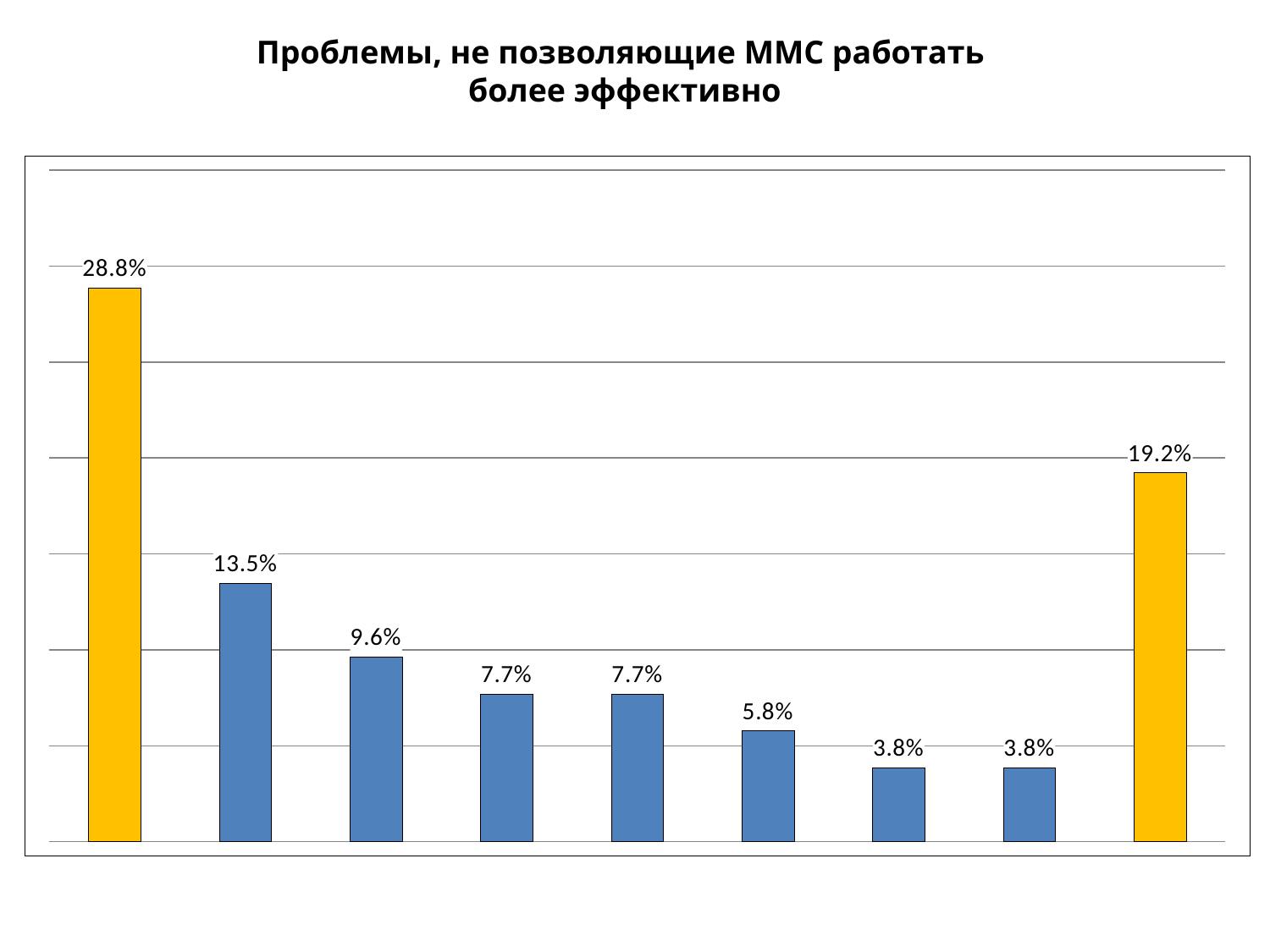
What is the highest value shown in the chart? 28.8% How many bars are plotted in the chart? 9 What is the difference between the first bar (28.8%) and the last bar (19.2%)? 9.6% What kind of chart is shown on the slide? bar chart What is the value of the second bar from the left? 13.5% What is the title of the chart? Проблемы, не позволяющие ММС работать более эффективно What is the lowest value shown in the chart? 3.8% What is the value of the first (leftmost) bar? 28.8% What is the value of the third bar from the left? 9.6% Which is larger: the second bar from the left or the rightmost bar? the rightmost bar How many bars are coloured yellow rather than blue? 2 What is the value of the last (rightmost) bar? 19.2%